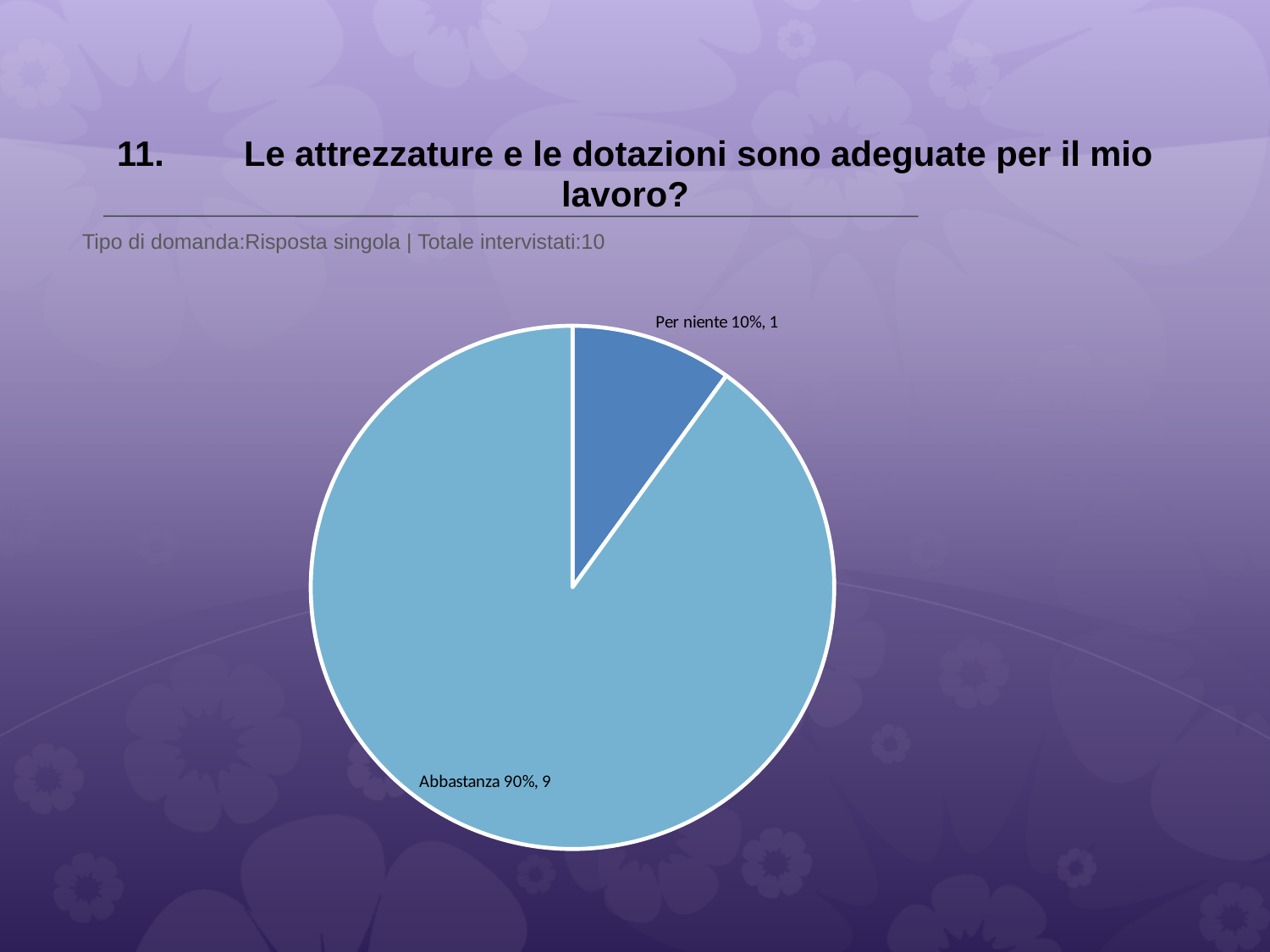
Which slice is larger, "Abbastanza" or "Per niente"? Abbastanza Which category has the smallest slice of the pie? Per niente How many slices does the pie chart have? 2 How many respondents answered "Per niente"? 1 What is the difference in number of respondents between "Abbastanza" and "Per niente"? 8 Which category has the largest slice of the pie? Abbastanza What share of the pie does the "Per niente" slice represent? 10% What share of the pie does the "Abbastanza" slice represent? 90% What is the total number of respondents shown in the pie chart? 10 What kind of chart is shown on the slide? pie chart What is the title of the question shown above the chart? Le attrezzature e le dotazioni sono adeguate per il mio lavoro? How many respondents answered "Abbastanza"? 9